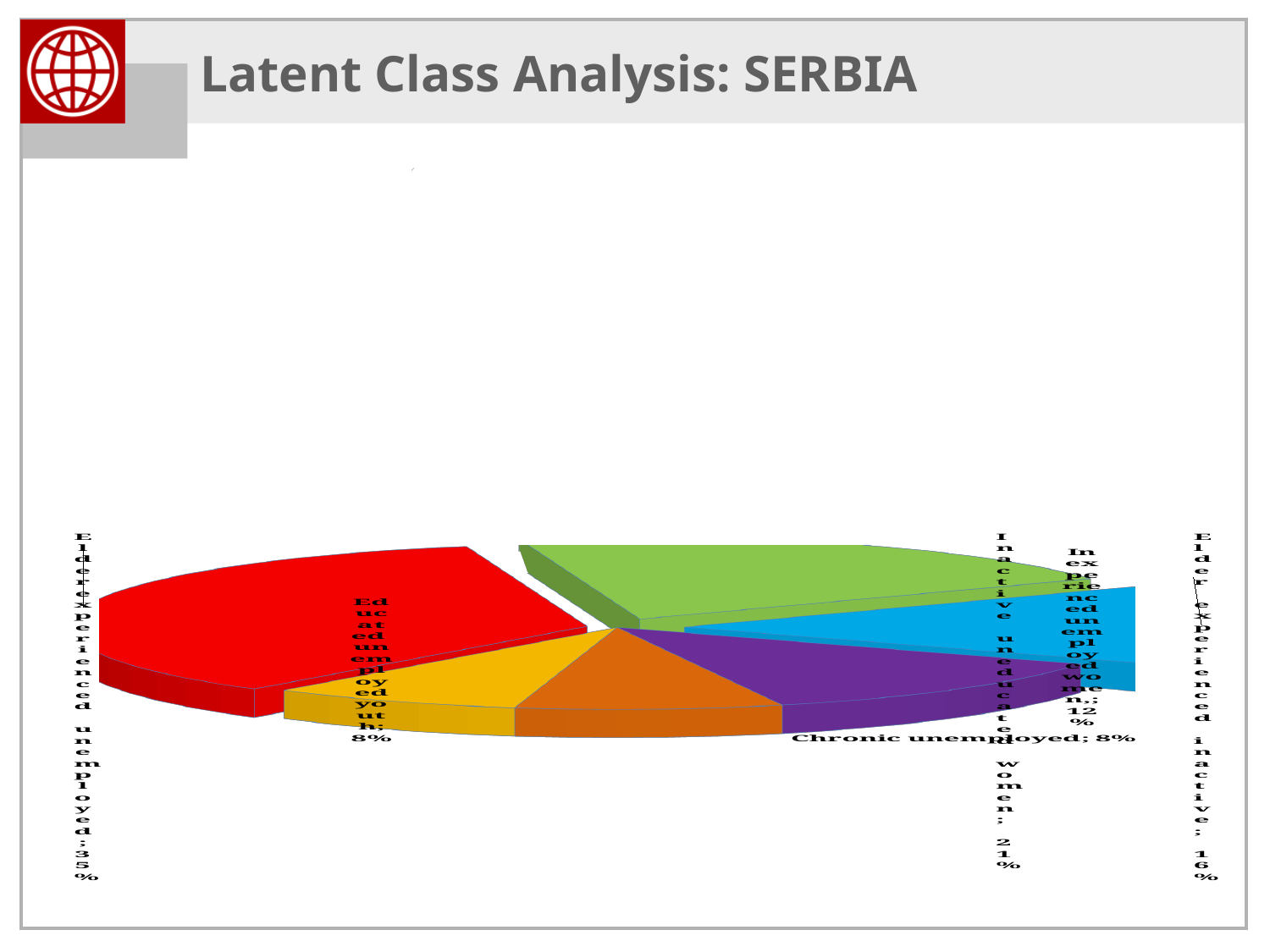
Which is larger, the share for "Elder experienced inactive" or the share for "Inexperienced unemployed women"? Elder experienced inactive What share of the pie is labelled "Elder experienced unemployed"? 35% What percentage is shown for "Chronic unemployed"? 8% What is the difference in percentage points between "Elder experienced unemployed" and "Inactive uneducated women"? 14 What is the combined share of "Educated unemployed youth" and "Chronic unemployed"? 16% What kind of chart is shown on the slide? pie chart How many slices does the pie chart have? 6 What percentage is shown for "Inexperienced unemployed women"? 12% Which category has the largest share of the pie? Elder experienced unemployed What percentage is shown for "Elder experienced inactive"? 16% What is the title of the slide containing the pie chart? Latent Class Analysis: SERBIA What percentage is shown for "Inactive uneducated women"? 21%